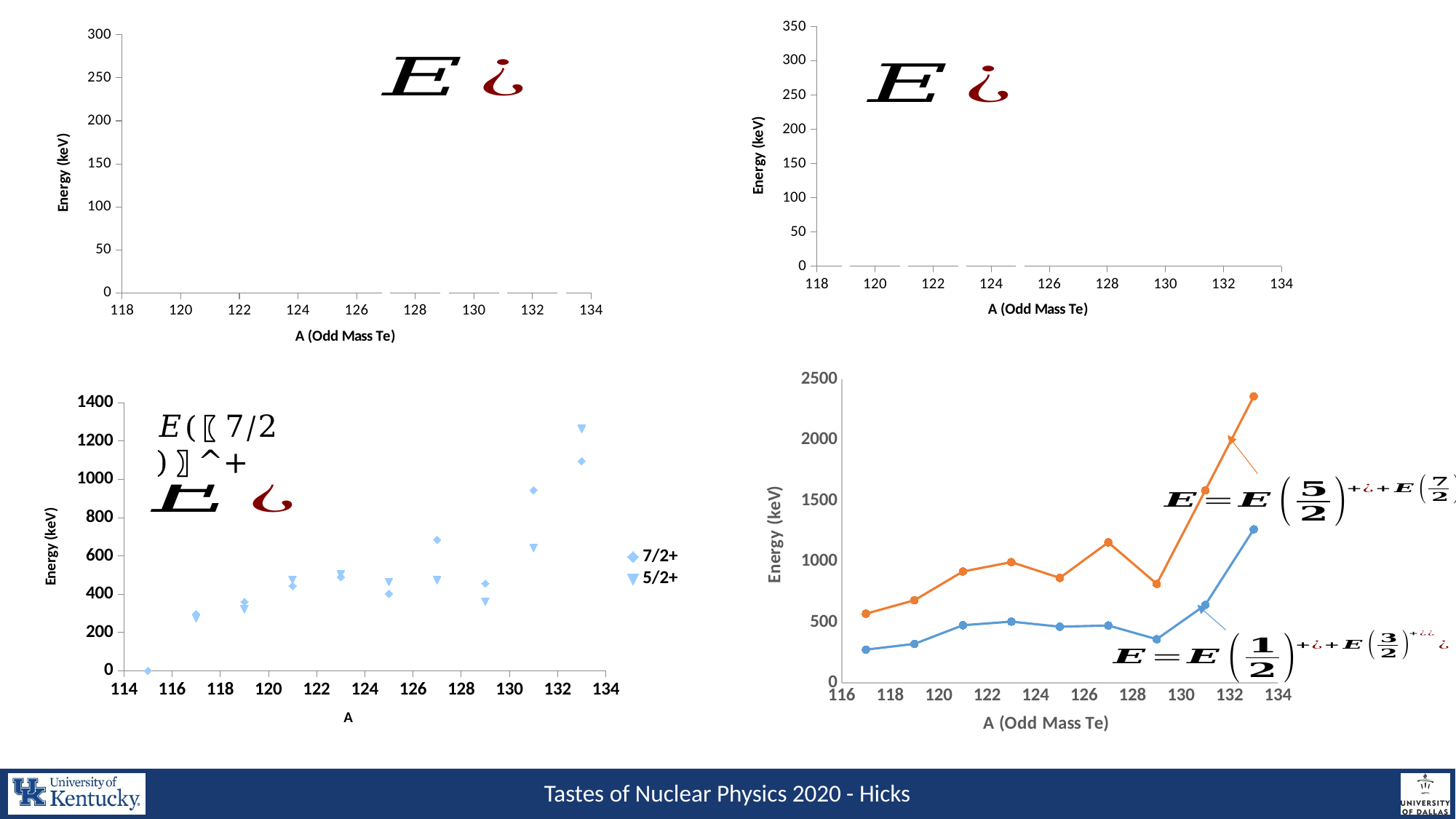
How many series does the legend of the bottom-left chart list? 2 On the bottom-left chart, is the 7/2+ value at A = 133 greater or less than 1000? greater On the bottom-left chart, which series has the higher value at A = 133, 7/2+ or 5/2+? 5/2+ On the bottom-left chart, at which value of A is the 5/2+ series highest? 133 On the bottom-left chart, is the 5/2+ value at A = 131 greater or less than 800? less On the bottom-right chart, is the orange line's value at A = 133 greater or less than 2000? greater What is the x-axis title of the bottom-right chart? A (Odd Mass Te) How many data points does each line on the bottom-right chart have? 9 What kind of chart is the bottom-right chart with the orange and blue lines? line chart On the bottom-right chart, which line is higher at A = 131, the orange line or the blue line? orange What kind of chart is the bottom-left chart with the 7/2+ and 5/2+ legend? scatter chart What are the two legend entries on the bottom-left chart? 7/2+ and 5/2+